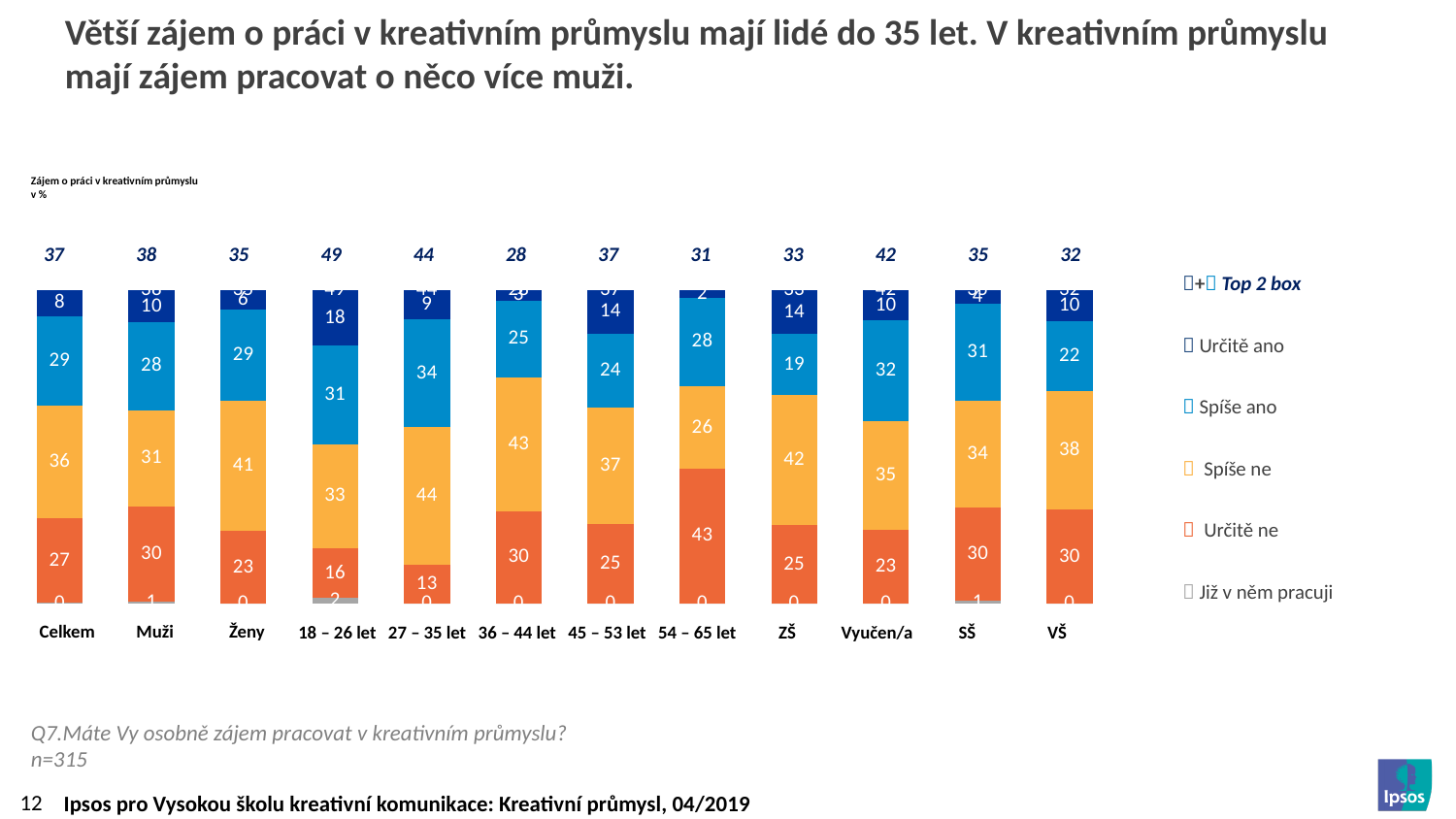
Which category has the lowest Top 2 box value? 36 – 44 let Which category has the highest Top 2 box value? 18 – 26 let Which has a larger 'Spíše ne' value, Muži or Ženy? Ženy How many categories are shown on the x axis of the chart? 12 How many series does the legend list (excluding the Top 2 box label)? 5 What is the Top 2 box value for the 18 – 26 let category? 49 What is the 'Určitě ano' value for the 45 – 53 let category? 14 What is the 'Určitě ne' value for the 54 – 65 let category? 43 What is the 'Spíše ano' value for the 27 – 35 let category? 34 What is the difference between the Top 2 box values for Muži and Ženy? 3 What kind of chart is shown on the slide? Stacked bar chart What is the title of the chart? Zájem o práci v kreativním průmyslu